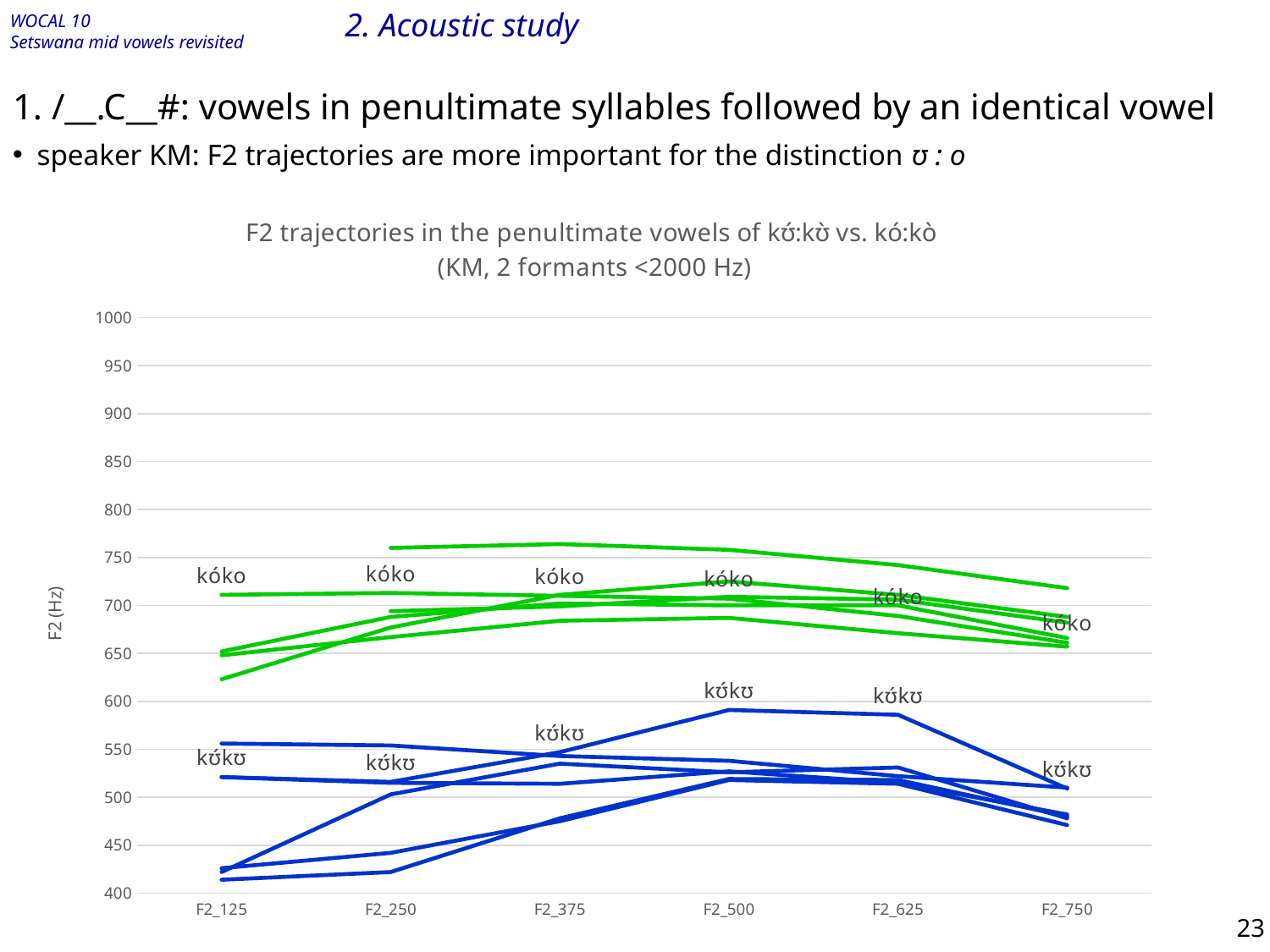
Is the lowest kʊ́kʊ value at F2_125 greater or less than 450? less Do the kʊ́kʊ trajectories generally rise or fall from F2_625 to F2_750? fall Are all kóko trajectories above or below 600 Hz across the whole chart? above At F2_500, are the F2 values for kóko higher or lower than those for kʊ́kʊ? higher Which word's trajectories are plotted in green, kóko or kʊ́kʊ? kóko What kind of chart is shown on the slide? line chart What is the label of the first category on the x axis? F2_125 Is the highest kʊ́kʊ value at F2_500 greater or less than 550? greater At which x-axis point does the highest kʊ́kʊ trajectory reach its peak? F2_500 What is the label of the y axis? F2 (Hz) How many time points (categories) are shown along the x axis? 6